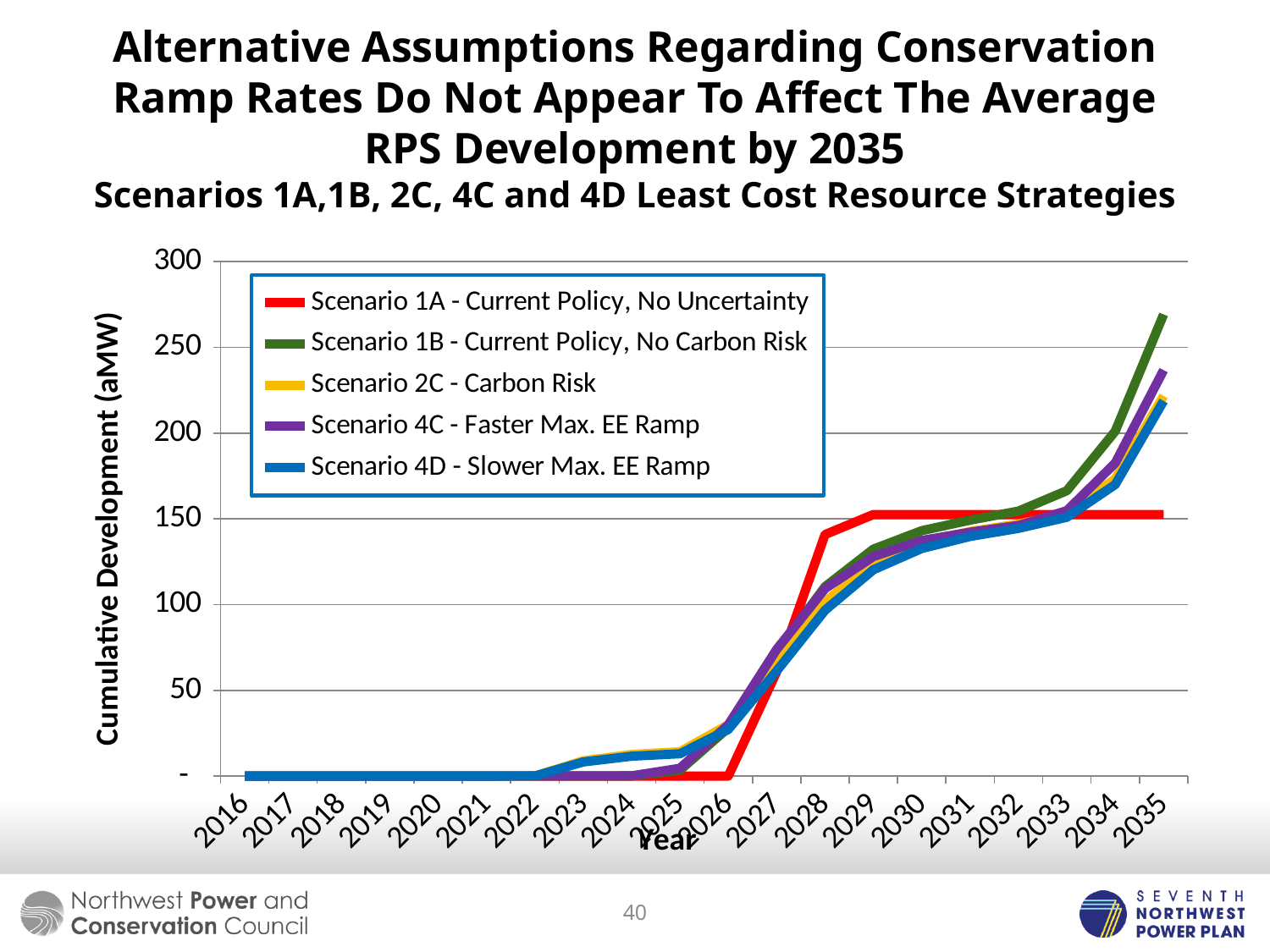
In 2028, which is larger: the value for Scenario 1A or the value for Scenario 4D? Scenario 1A Is the value for Scenario 4D in 2035 greater or less than 200? greater Is the value for Scenario 1B in 2035 greater or less than 250? greater What is the label of the y axis? Cumulative Development (aMW) Does the value for Scenario 1A rise, fall or stay flat from 2029 to 2035? Stays flat How many years are shown along the x axis? 20 Which scenario has the highest cumulative development in 2035? Scenario 1B - Current Policy, No Carbon Risk What kind of chart is shown on the slide? Line chart Which scenario has the lowest cumulative development in 2035? Scenario 1A - Current Policy, No Uncertainty Is the value for Scenario 1A in 2028 greater or less than 100? greater How many series does the legend list? 5